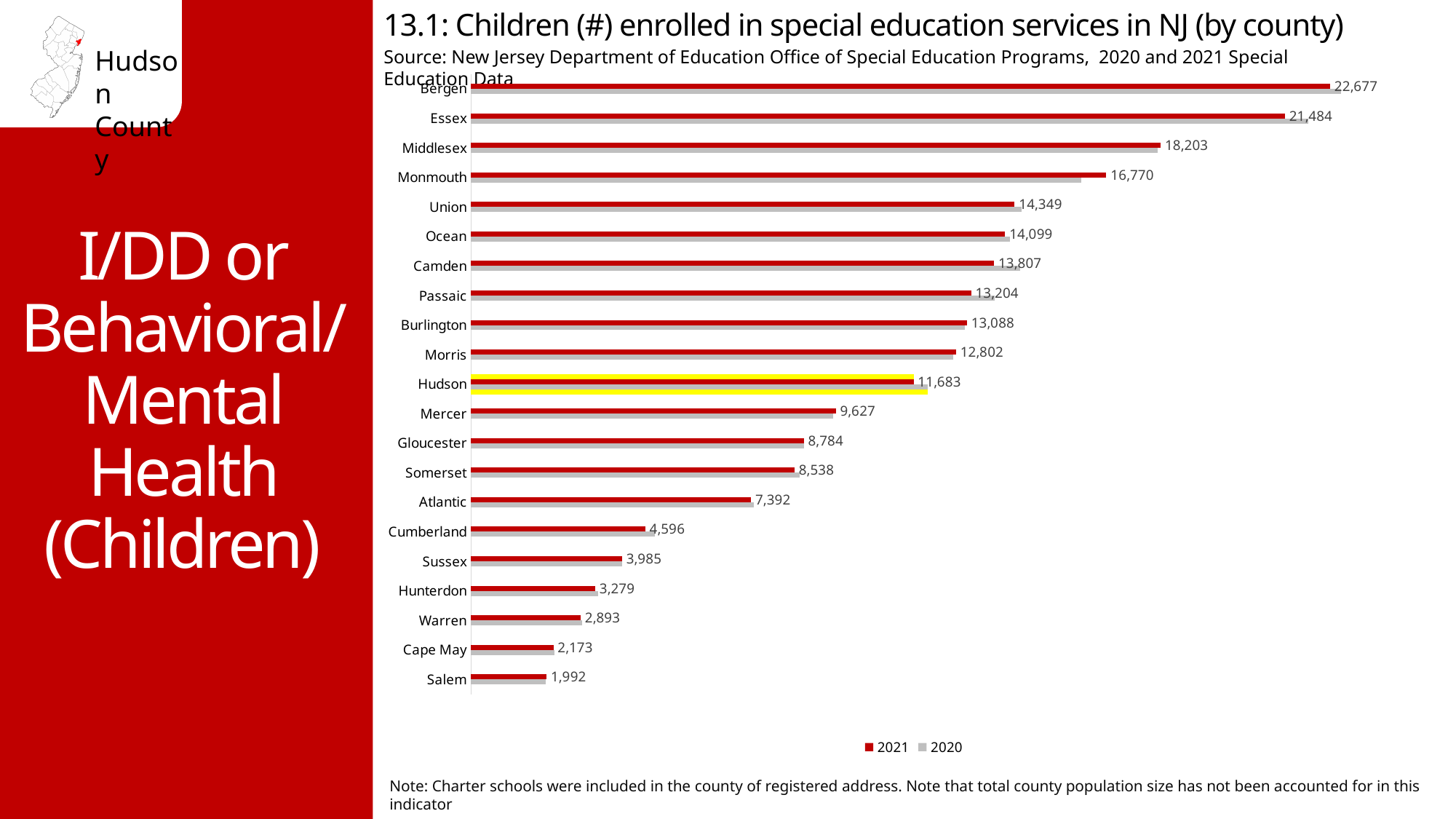
What is the difference between the 2021 values for Bergen and Essex? 1,193 How many series does the legend list? 2 Which county has the lowest number of children enrolled in special education services in 2021? Salem What is the 2021 value for Hudson county? 11,683 What is the 2021 value for Salem county? 1,992 What is the difference between the 2021 values for Hudson and Mercer? 2,056 How many counties are shown on the chart? 21 Which county has a larger 2021 value, Union or Ocean? Union Which county has the highest number of children enrolled in special education services in 2021? Bergen Which county's bars are highlighted in yellow on the chart? Hudson What is the 2021 value for Bergen county? 22,677 What kind of chart is shown on the slide? Bar chart